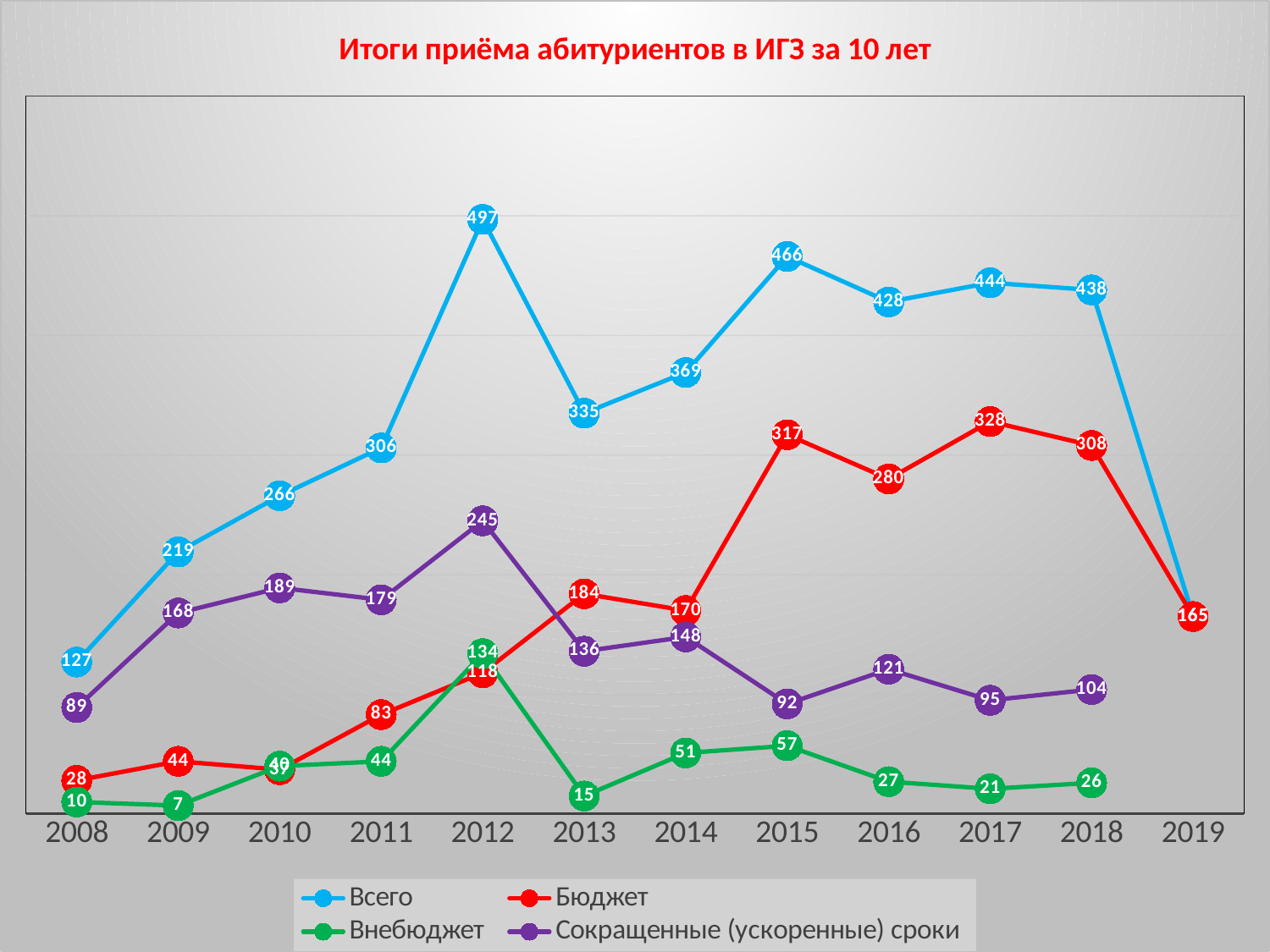
What is the value of the Сокращенные (ускоренные) сроки series in 2012? 245 How many series does the legend list? 4 What kind of chart is shown on the slide? line chart What is the title of the chart? Итоги приёма абитуриентов в ИГЗ за 10 лет What is the difference between the Всего values for 2015 and 2016? 38 Does the Всего series rise or fall from 2008 to 2012? rise In which year does the Всего series reach its highest value? 2012 What is the value of the Всего series in 2012? 497 What is the value of the Бюджет series in 2017? 328 How many years are shown on the x axis? 12 In which year is the Внебюджет series at its lowest? 2009 In 2015, which is larger: the Бюджет value or the Сокращенные (ускоренные) сроки value? Бюджет